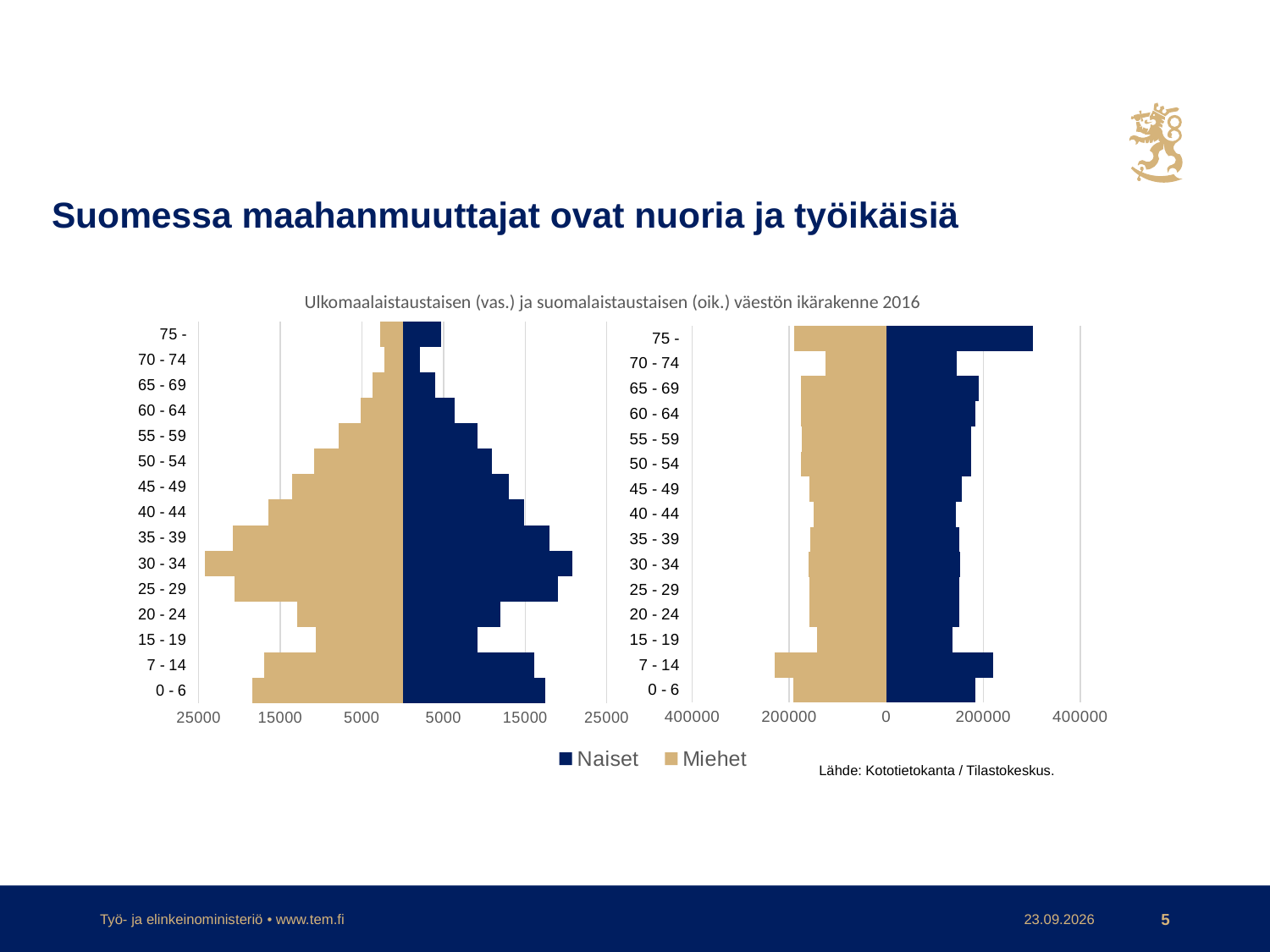
How many age groups are shown on the left chart? 15 On the right chart (suomalaistaustainen), which age group has the shortest Miehet bar? 70 - 74 What kind of chart is the left chart on the slide? bar chart How many series does the legend list? 2 On the right chart (suomalaistaustainen), which age group has the longest Naiset bar? 75 - On the right chart, is the Naiset value for 75 - greater or less than 200000? greater What are the two series named in the legend? Naiset and Miehet On the left chart (ulkomaalaistaustainen), which age group has the longest Naiset bar? 30 - 34 On the right chart, which is larger for the 75 - age group, Naiset or Miehet? Naiset On the left chart (ulkomaalaistaustainen), which age group has the shortest Naiset bar? 70 - 74 On the left chart, going from the 30 - 34 group up to the 70 - 74 group, do the Naiset bars get longer or shorter? shorter On the left chart, is the Miehet value for 30 - 34 greater or less than 15000? greater